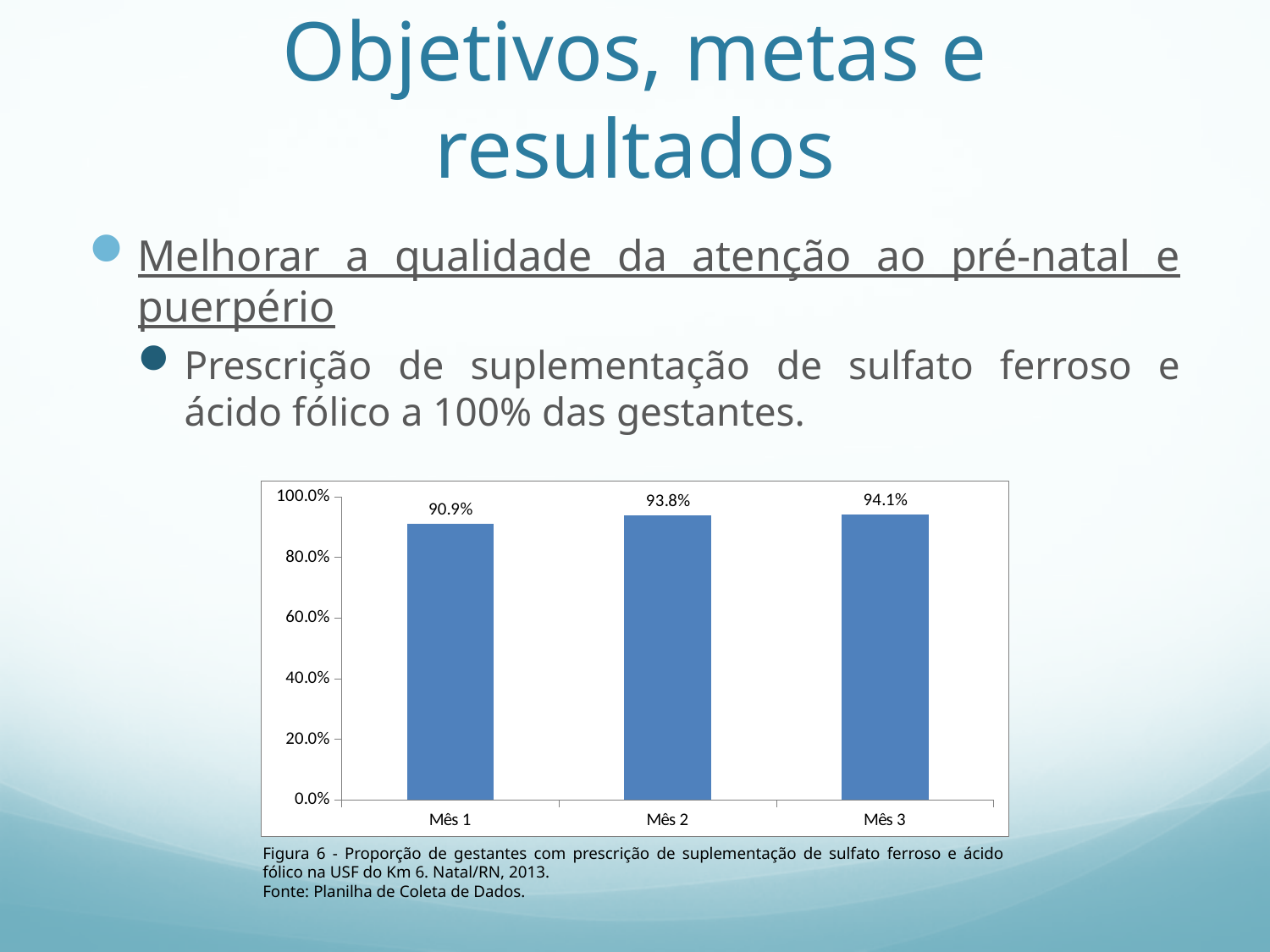
What kind of chart is shown on the slide? Bar chart Which is larger, the value for Mês 1 or the value for Mês 3? Mês 3 How many months are shown on the x axis? 3 What is the difference between the values for Mês 3 and Mês 1? 3.2 percentage points What is the value for Mês 2? 93.8% Is the value for Mês 1 greater or less than 80.0%? greater Do the values rise or fall from Mês 1 to Mês 3? Rise What is the difference between the values for Mês 2 and Mês 1? 2.9 percentage points What is the value for Mês 1? 90.9% Which month has the highest value? Mês 3 What is the value for Mês 3? 94.1% Which month has the lowest value? Mês 1